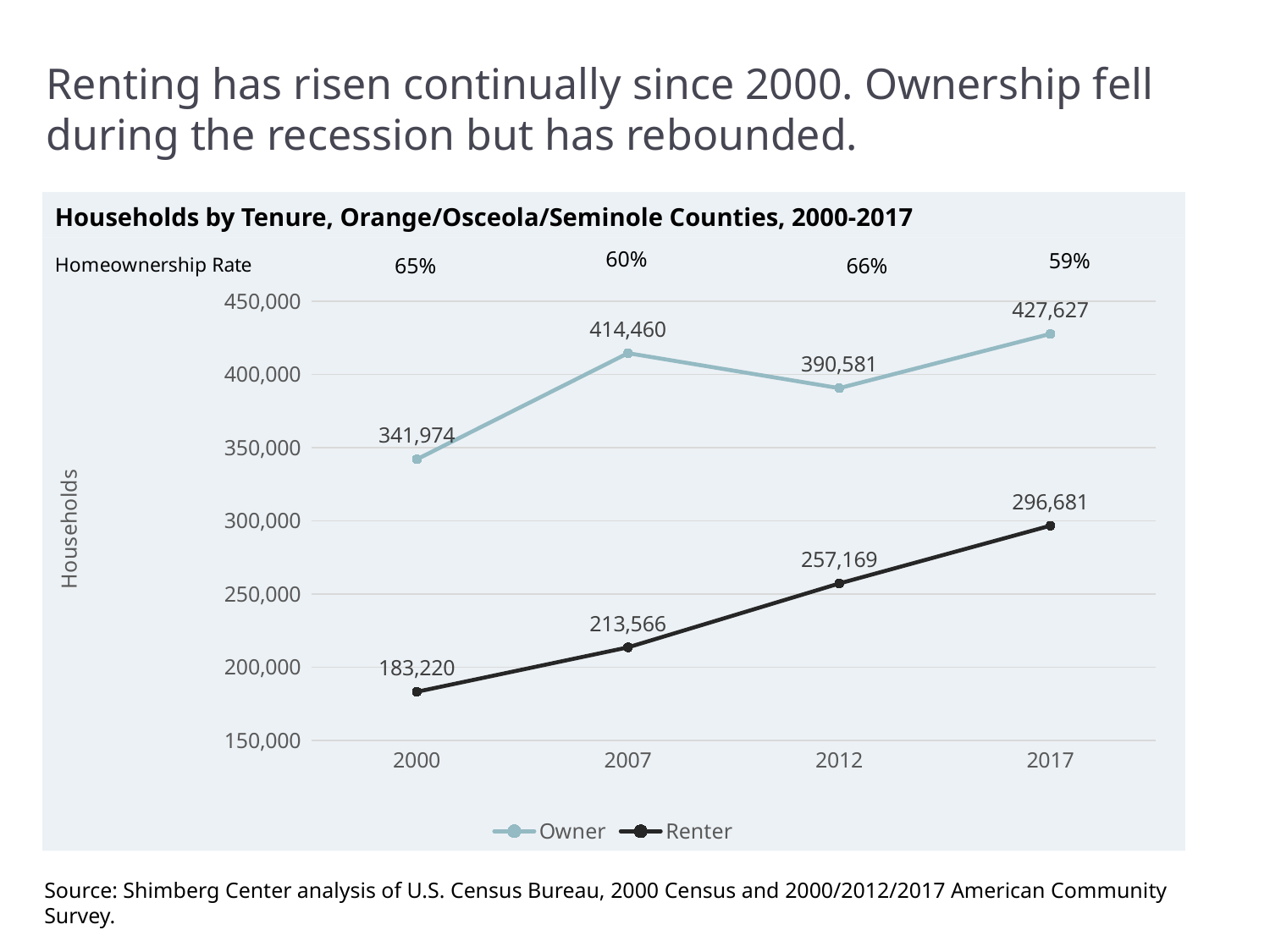
What kind of chart is shown? Line chart In which year is the Owner series lowest? 2000 What is the difference between Owner and Renter households in 2017? 130,946 Does the Renter series rise or fall from 2000 to 2017? Rise In which year is the Renter series highest? 2017 How many series does the legend list? 2 What is the value for Owner households in 2012? 390,581 How many years are plotted on the x axis? 4 What homeownership rate is shown above the chart for 2017? 59% What is the value for Renter households in 2007? 213,566 Which is larger, Owner households in 2007 or Owner households in 2012? Owner households in 2007 By how much did Renter households increase from 2000 to 2017? 113,461